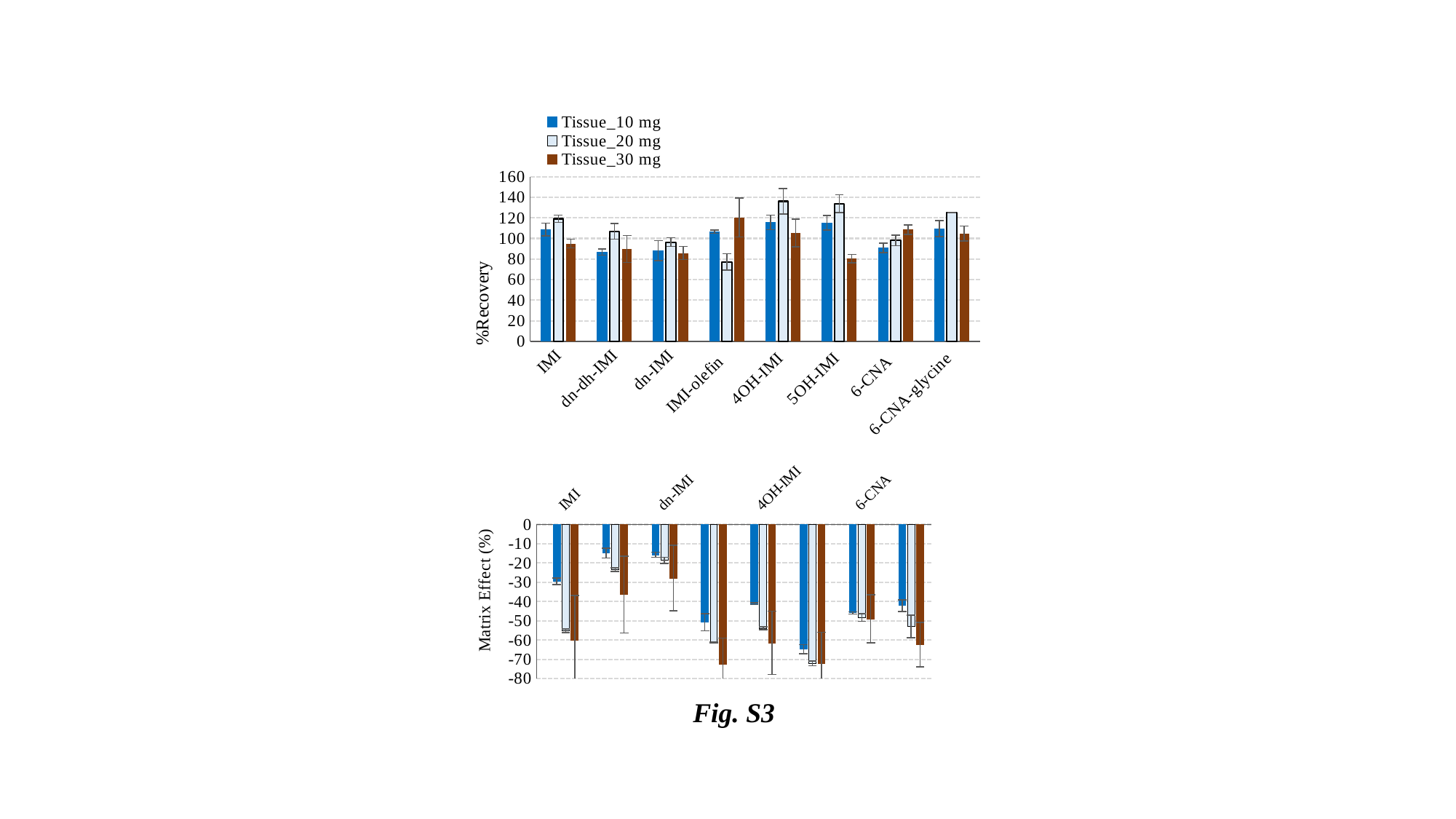
In the top chart (%Recovery), which is larger for IMI: the Tissue_20 mg value or the Tissue_30 mg value? Tissue_20 mg In the top chart (%Recovery), is the Tissue_20 mg value for 4OH-IMI greater or less than 120? greater In the top chart (%Recovery), which is larger for 5OH-IMI: the Tissue_20 mg value or the Tissue_30 mg value? Tissue_20 mg In the bottom chart (Matrix Effect (%)), is the Tissue_10 mg value for IMI greater or less than -20? less What kind of chart is the bottom chart (Matrix Effect (%))? bar chart In the top chart (%Recovery), is the Tissue_30 mg value for 5OH-IMI greater or less than 100? less In the top chart (%Recovery), how many series does the legend list? 3 In the top chart (%Recovery), which series has the lowest value for IMI-olefin? Tissue_20 mg In the top chart (%Recovery), how many categories are shown on the x axis? 8 In the top chart (%Recovery), which series has the highest value for 4OH-IMI? Tissue_20 mg What kind of chart is the top chart (%Recovery)? bar chart